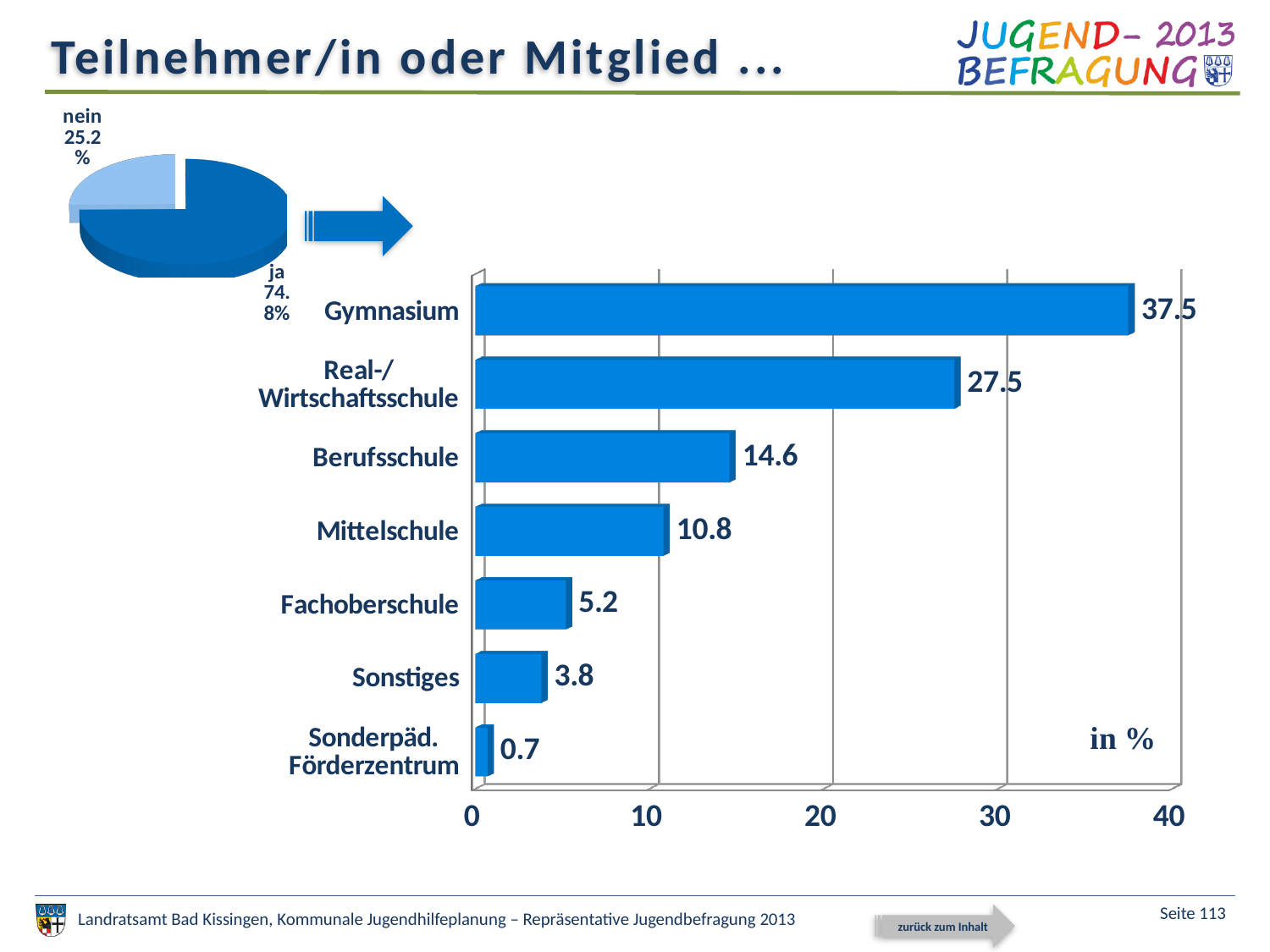
In the pie chart, what share is labelled 'nein'? 25.2% In the bar chart, what unit is indicated by the label inside the plot area? in % In the pie chart, what share is labelled 'ja'? 74.8% What kind of chart is the larger chart on the right of the slide? bar chart In the bar chart, what is the value for Sonderpäd. Förderzentrum? 0.7 In the bar chart, what is the difference between the values for Gymnasium and Real-/Wirtschaftsschule? 10 In the bar chart, how many categories are shown? 7 In the bar chart, what is the value for Gymnasium? 37.5 In the bar chart, which is larger: the value for Mittelschule or the value for Fachoberschule? Mittelschule In the bar chart, which category has the highest value? Gymnasium In the bar chart, which category has the lowest value? Sonderpäd. Förderzentrum In the bar chart, what is the value for Berufsschule? 14.6